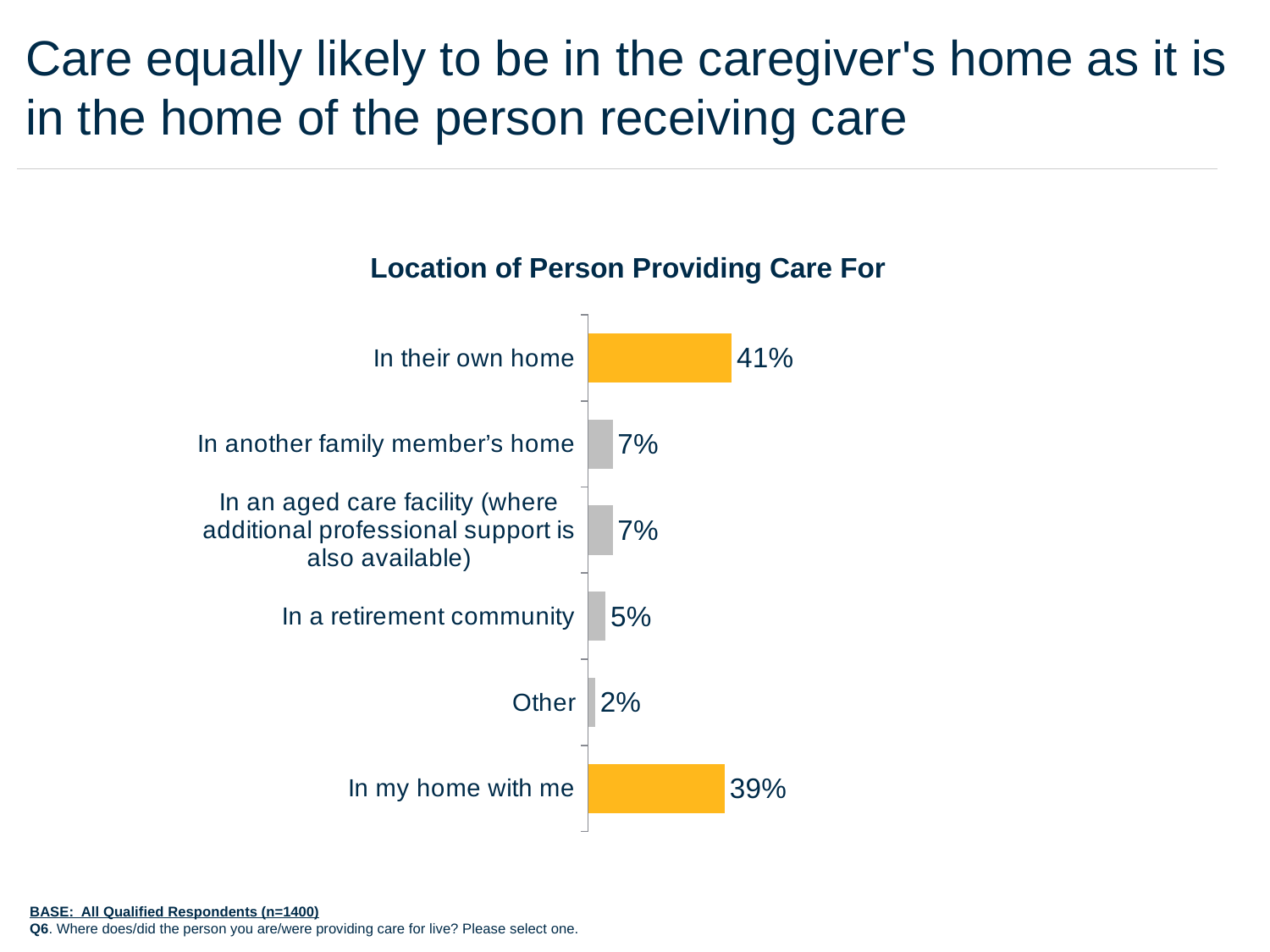
Which location has the lowest percentage? Other What percentage of respondents said the person they care for lives in their own home? 41% What is the value for "In a retirement community"? 5% What is the value for "Other"? 2% Which location has the highest percentage? In their own home What is the difference between "In another family member's home" and "Other"? 5% What type of chart is shown on the slide? Bar chart What is the title of the chart? Location of Person Providing Care For Which is larger: "In a retirement community" or "In an aged care facility"? In an aged care facility What is the value for "In my home with me"? 39% How many location categories are shown in the chart? 6 What is the difference between "In their own home" and "In my home with me"? 2%